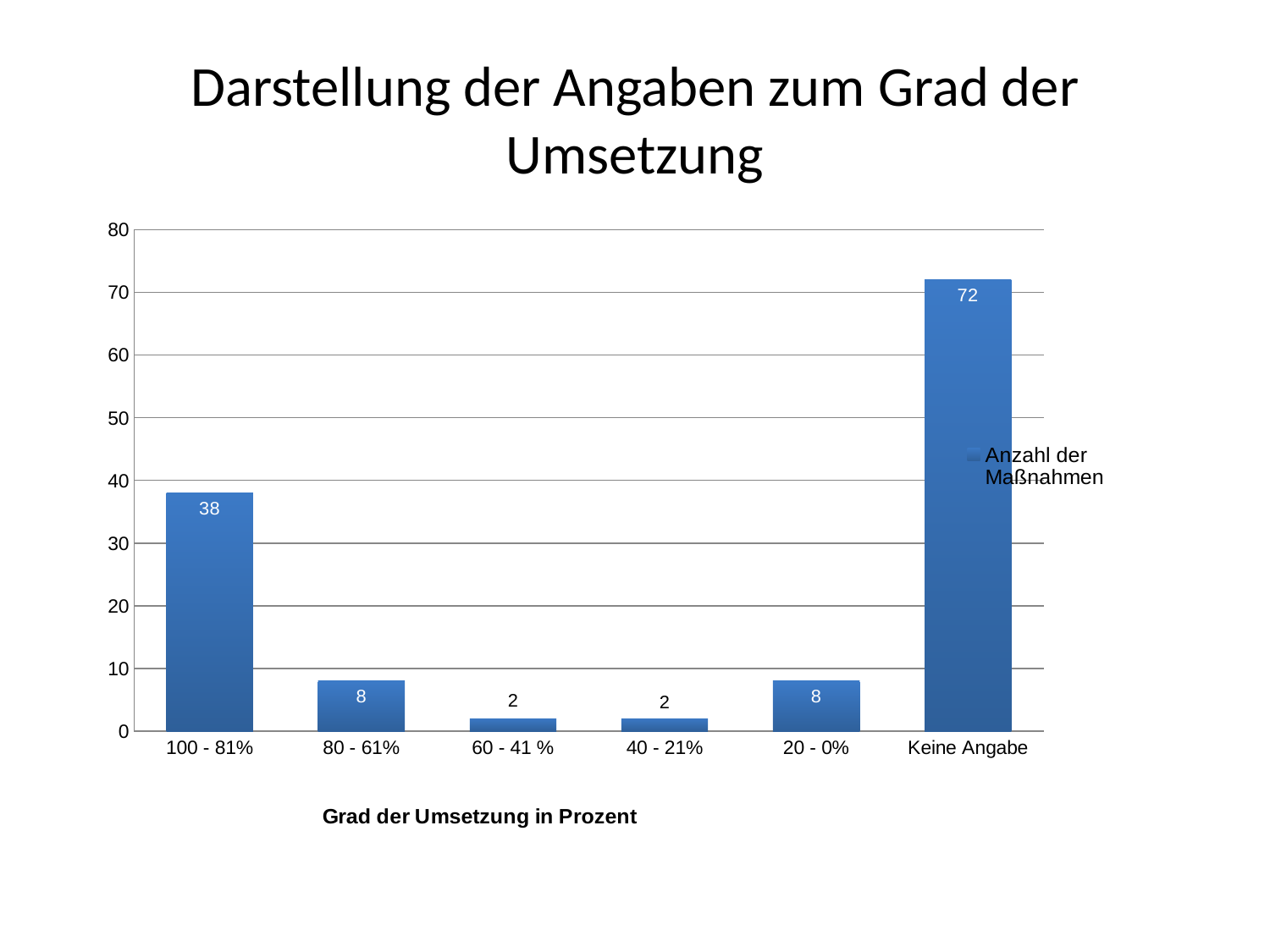
How many series does the legend list? 1 Is the value for "Keine Angabe" greater or less than 70? greater What kind of chart is shown on the slide? bar chart What is the name of the series listed in the legend? Anzahl der Maßnahmen Which is larger, the value for "100 - 81%" or the value for "80 - 61%"? 100 - 81% What is the value for the category "60 - 41 %"? 2 What is the x-axis title of the chart? Grad der Umsetzung in Prozent What is the difference between the values for "Keine Angabe" and "100 - 81%"? 34 What is the value for the category "Keine Angabe"? 72 Which category has the highest value? Keine Angabe How many categories are shown on the x axis? 6 What is the value for the category "100 - 81%"? 38